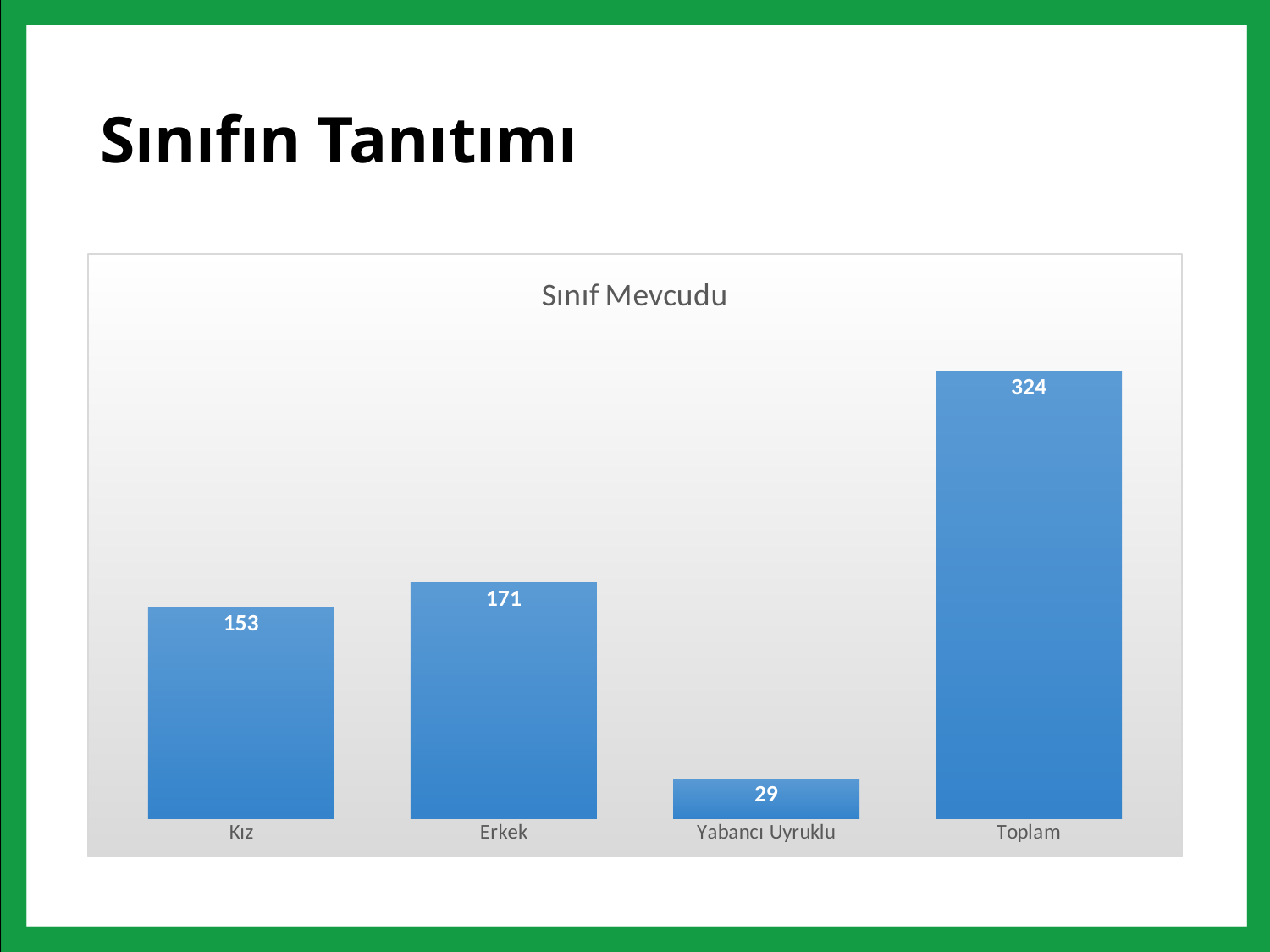
What kind of chart is shown on the slide? Bar chart What is the value for Yabancı Uyruklu? 29 How many categories are shown in the chart? 4 Which category has the lowest value? Yabancı Uyruklu What is the value for Erkek? 171 Which category has the highest value? Toplam Which is larger, the value for Kız or the value for Erkek? Erkek What is the difference between the values for Toplam and Yabancı Uyruklu? 295 What is the title of the chart? Sınıf Mevcudu What is the value for Kız? 153 What is the value for Toplam? 324 What is the difference between the values for Erkek and Kız? 18